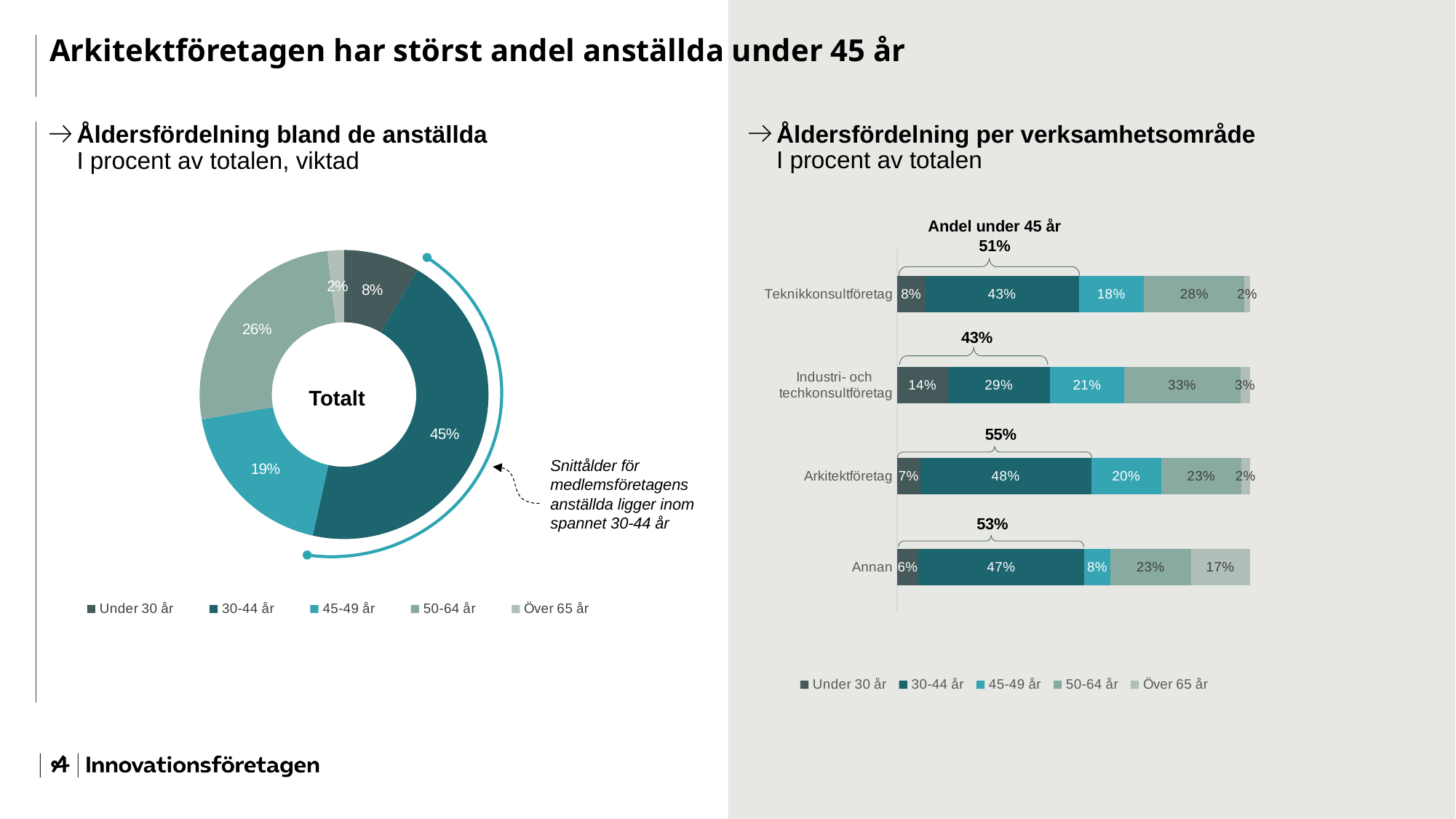
What kind of chart is shown on the left side of the slide? Donut (pie) chart In the bar chart on the right, which business area has the highest 'Andel under 45 år'? Arkitektföretag How many business areas (categories) are shown in the bar chart on the right? 4 In the donut chart on the left (Åldersfördelning bland de anställda), what share of employees are aged 30-44 år? 45% In the donut chart on the left, which age group has the smallest share? Över 65 år In the donut chart on the left, which age group has the largest share? 30-44 år In the bar chart on the right, which business area has the lowest 'Andel under 45 år'? Industri- och techkonsultföretag In the donut chart on the left, what is the difference between the share for 50-64 år and the share for 45-49 år? 7% In the bar chart on the right, what is the share of employees aged Över 65 år for Annan? 17% How many age groups does the legend of the donut chart on the left list? 5 In the bar chart on the right (Åldersfördelning per verksamhetsområde), what is the share of employees aged 30-44 år at Arkitektföretag? 48% In the bar chart on the right, which is larger: the 45-49 år share for Industri- och techkonsultföretag or for Annan? Industri- och techkonsultföretag